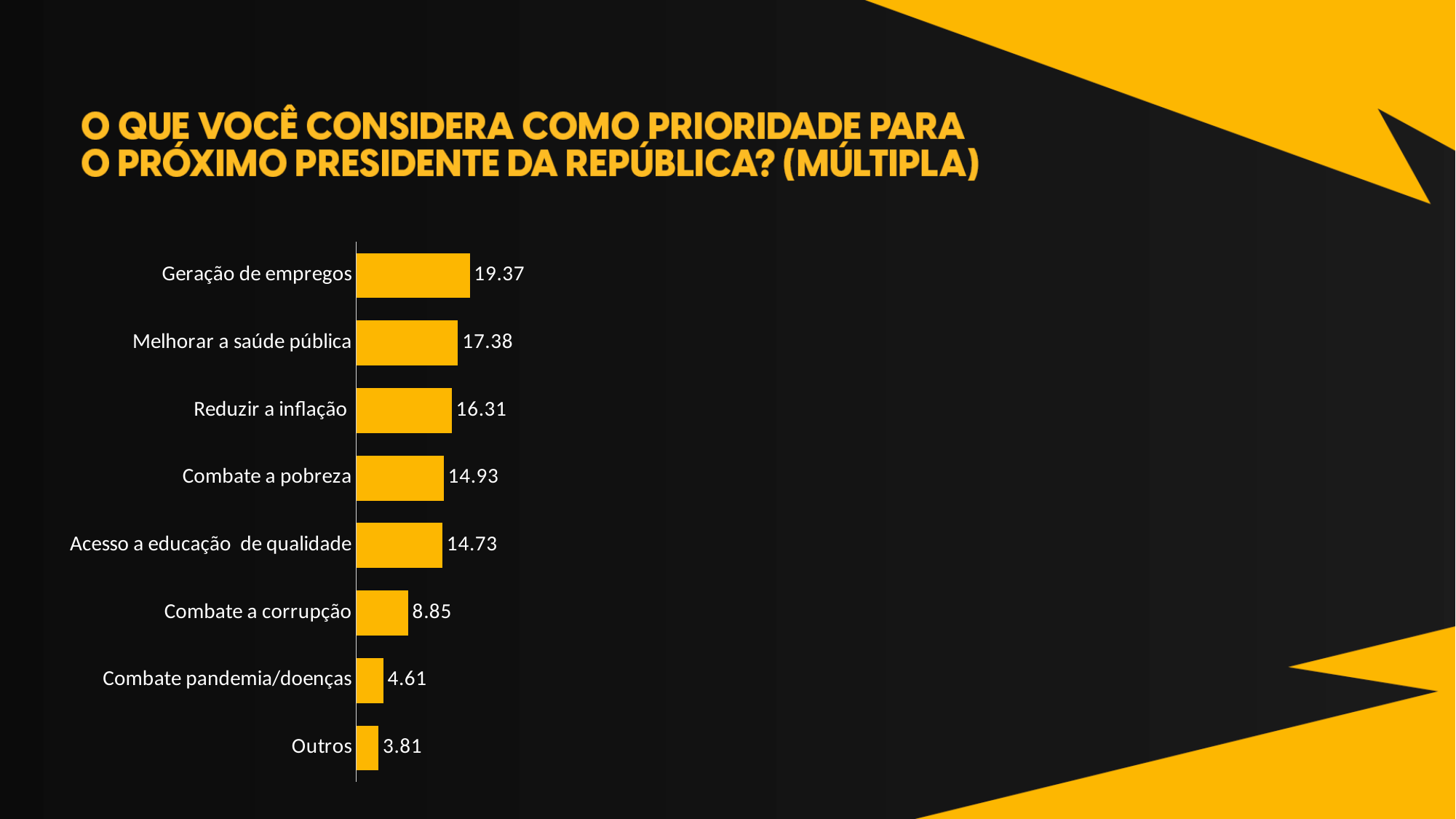
What colour are the bars in the chart? Yellow What is the value for Acesso a educação de qualidade? 14.73 Which is larger, Reduzir a inflação or Combate a pobreza? Reduzir a inflação What is the value for Geração de empregos? 19.37 What is the value for Combate a corrupção? 8.85 What is the value for Outros? 3.81 What kind of chart is shown on the slide? Bar chart Which category has the lowest value? Outros What is the difference between Geração de empregos and Melhorar a saúde pública? 1.99 Which category has the highest value? Geração de empregos What is the difference between Combate a corrupção and Combate pandemia/doenças? 4.24 How many categories are shown in the chart? 8